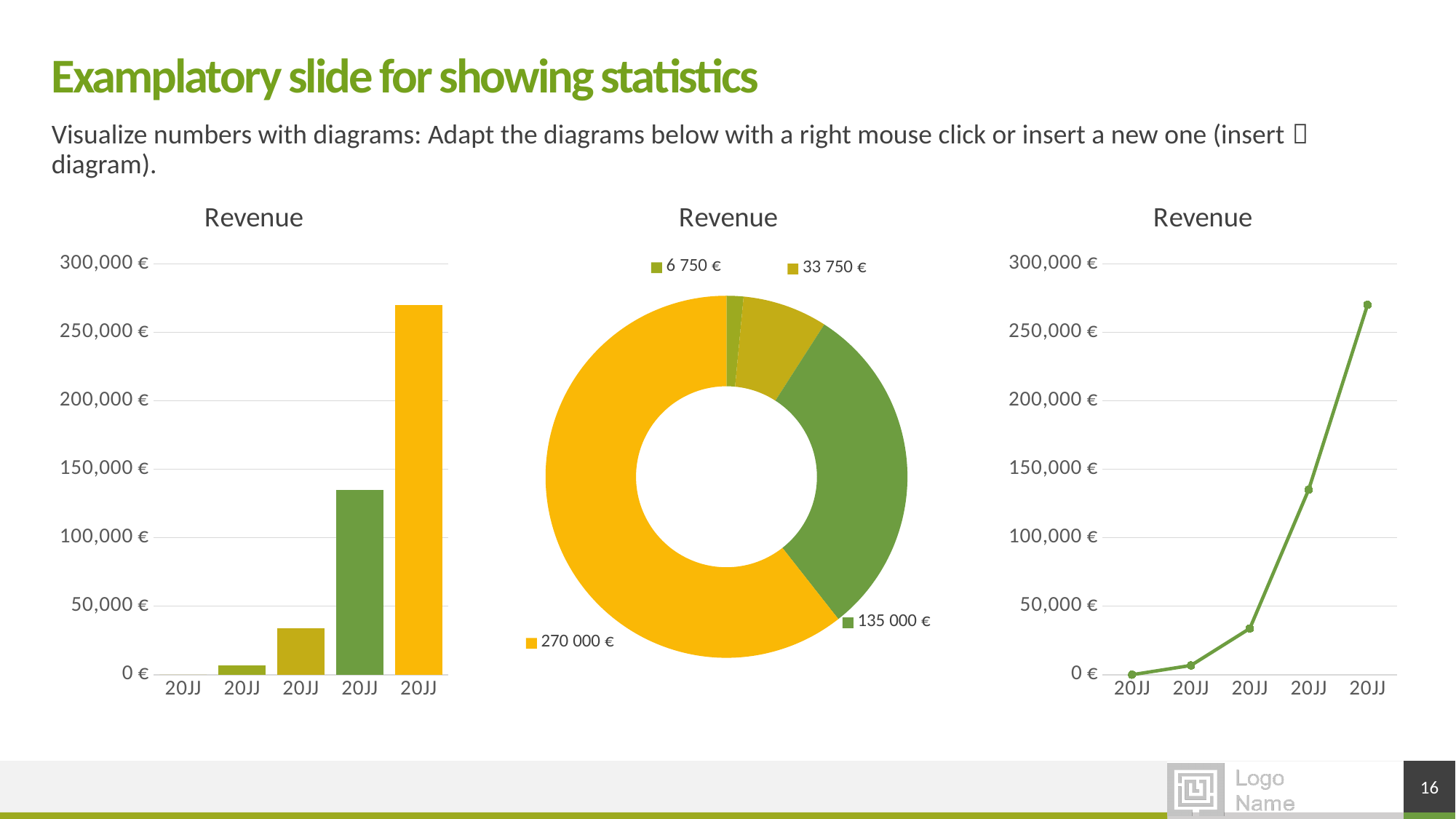
In the middle doughnut chart, what is the value of the largest slice? 270 000 € What kind of chart is the rightmost chart on the slide? line chart What kind of chart is the leftmost chart on the slide? bar chart In the leftmost bar chart, is the value of the rightmost bar greater or less than 250,000 €? greater In the rightmost line chart, is the value of the last point greater or less than 250,000 €? greater In the leftmost bar chart, how many bars (categories) are shown on the x axis? 5 In the middle doughnut chart, what is the difference between the 270 000 € slice and the 135 000 € slice? 135 000 € In the middle doughnut chart, what is the value of the smallest labelled slice? 6 750 € In the rightmost line chart, do the values rise or fall from left to right along the x axis? rise In the leftmost bar chart, is the value of the fourth bar from the left greater or less than 150,000 €? less In the leftmost bar chart, which bar is the tallest? the rightmost (fifth) bar What kind of chart is the middle chart on the slide? doughnut chart